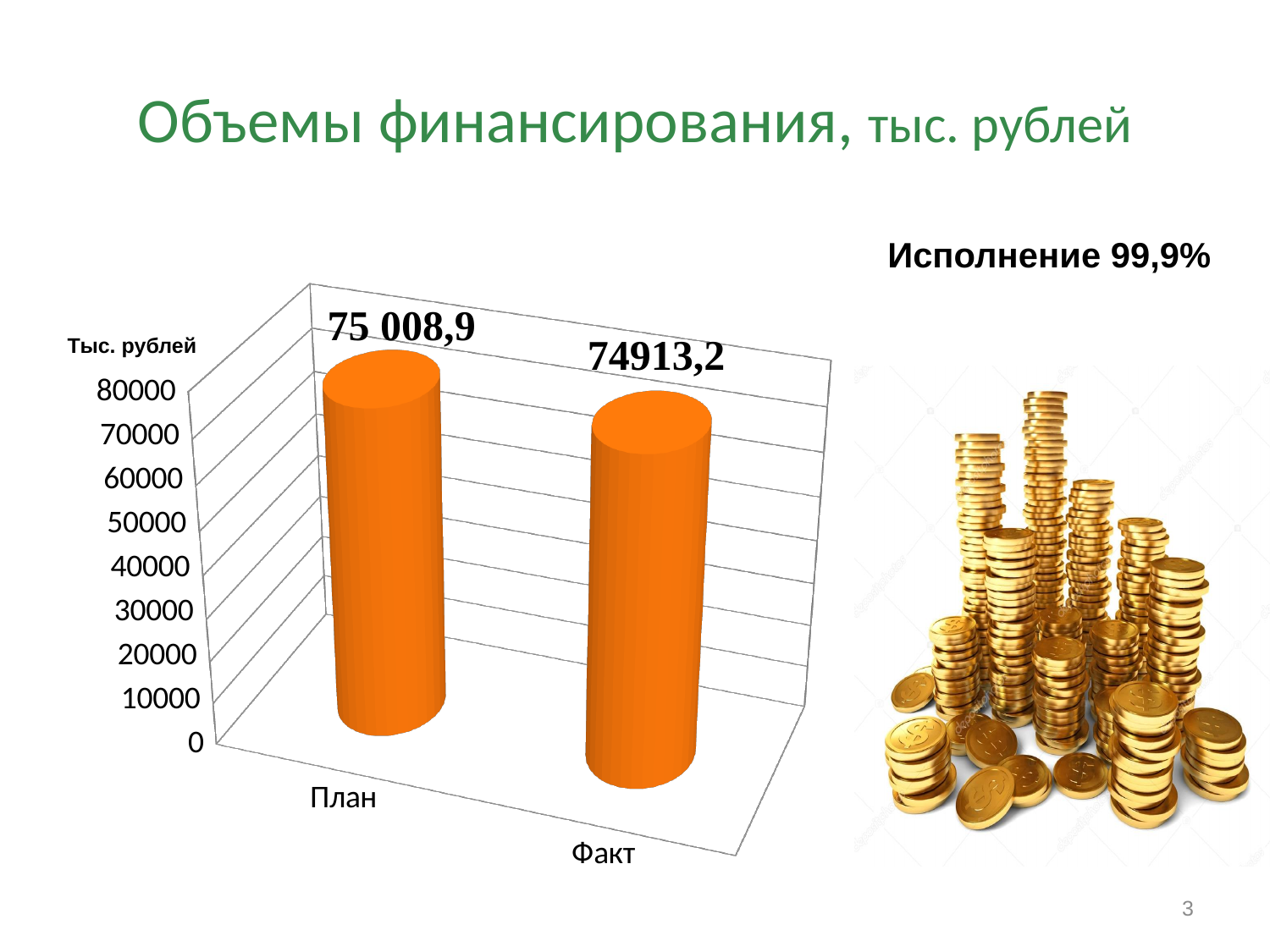
What is the highest tick value shown on the vertical axis? 80000 Is the value for Факт greater or less than 80000? less What is the difference between the План value and the Факт value? 95,7 What is the value for Факт? 74913,2 What is the value for План? 75 008,9 What label is shown on the vertical axis of the chart? Тыс. рублей What kind of chart is shown on the slide? bar chart What is the title of the slide? Объемы финансирования, тыс. рублей Which category has the higher value, План or Факт? План How many categories are shown on the chart? 2 Is the value for План greater or less than 70000? greater